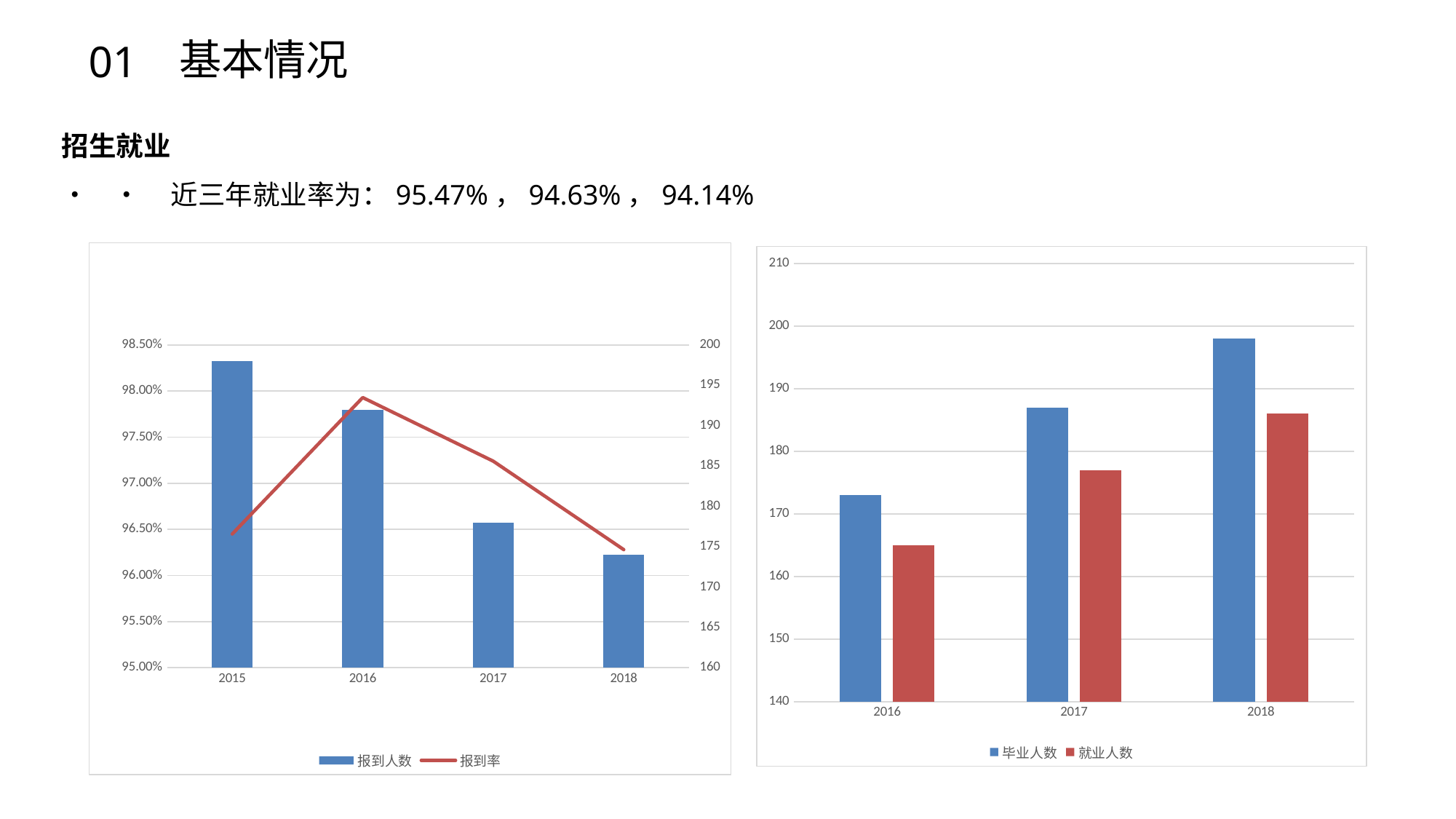
On the right chart, which year has the lowest 就业人数 bar? 2016 On the right chart, is the 就业人数 value for 2016 greater or less than 170? less On the left chart, which year has the tallest 报到人数 bar? 2015 On the right chart, how many series does the legend list? 2 On the right chart, is the 就业人数 value for 2018 greater or less than 180? greater On the left chart, do the 报到人数 bars rise or fall from 2015 to 2018? fall On the left chart, how many years are shown on the x axis? 4 On the right chart, which is larger in 2017: 毕业人数 or 就业人数? 毕业人数 On the right chart, do the 毕业人数 values rise or fall from 2016 to 2018? rise On the right chart, is the 毕业人数 value for 2018 greater or less than 190? greater On the left chart, in which year does the 报到率 line reach its peak? 2016 On the right chart, which year has the highest 毕业人数 bar? 2018